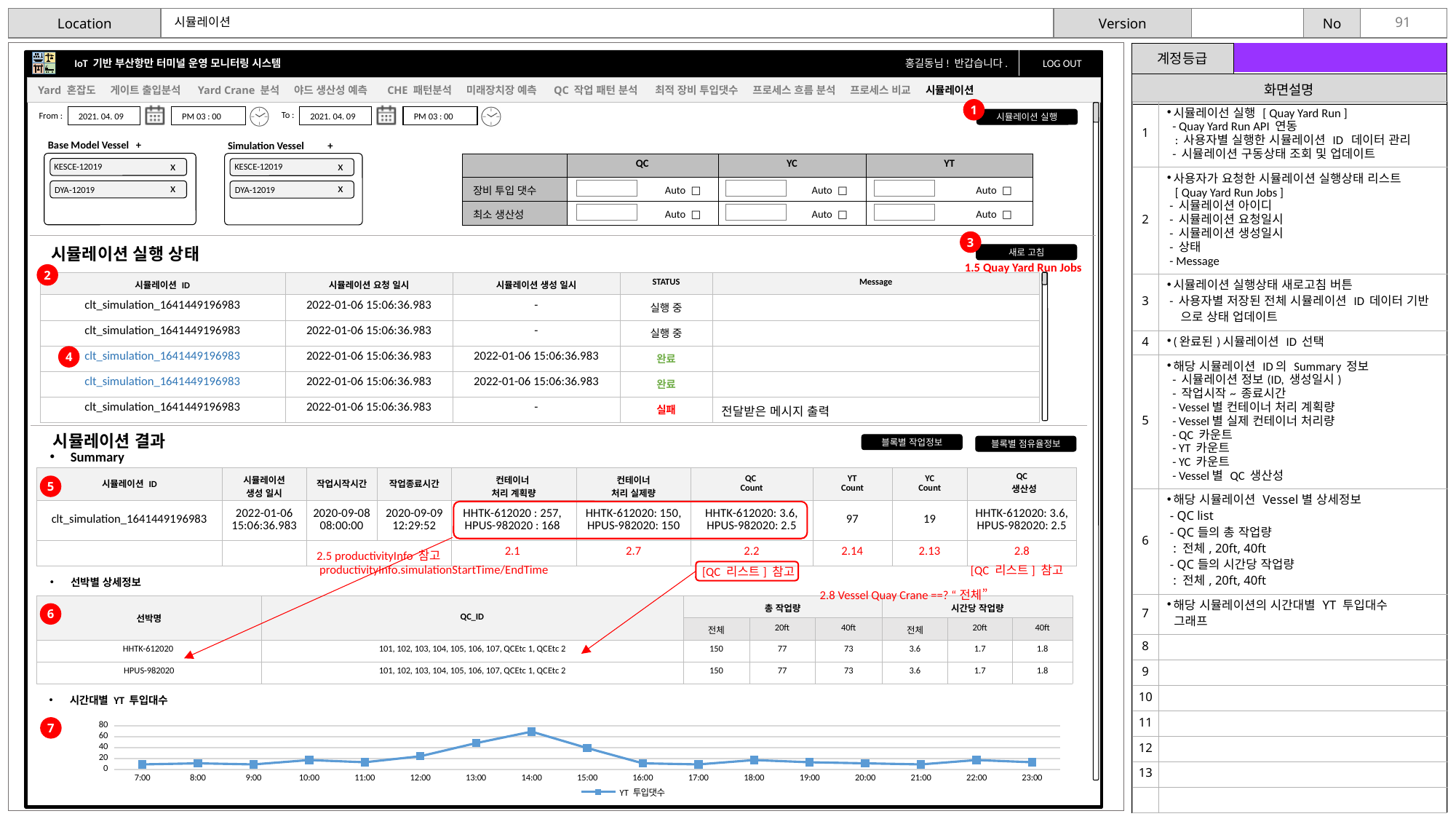
What is the name of the series shown in the legend of the '시간대별 YT 투입대수' chart? YT 투입댓수 In the '시간대별 YT 투입대수' chart, is the value at 13:00 greater or less than 40? greater At which time does the '시간대별 YT 투입대수' chart reach its highest value? 14:00 In the '시간대별 YT 투입대수' chart, is the value at 7:00 greater or less than 20? less What kind of chart is the '시간대별 YT 투입대수' chart at the bottom of the slide? line chart In the '시간대별 YT 투입대수' chart, which is larger, the value at 13:00 or the value at 12:00? 13:00 In the '시간대별 YT 투입대수' chart, do the values rise or fall from 14:00 to 17:00? fall What is the highest tick value shown on the y axis of the '시간대별 YT 투입대수' chart? 80 In the '시간대별 YT 투입대수' chart, is the value at 14:00 greater or less than 60? greater How many time points are plotted along the x axis of the '시간대별 YT 투입대수' chart? 17 How many series does the legend of the '시간대별 YT 투입대수' chart list? 1